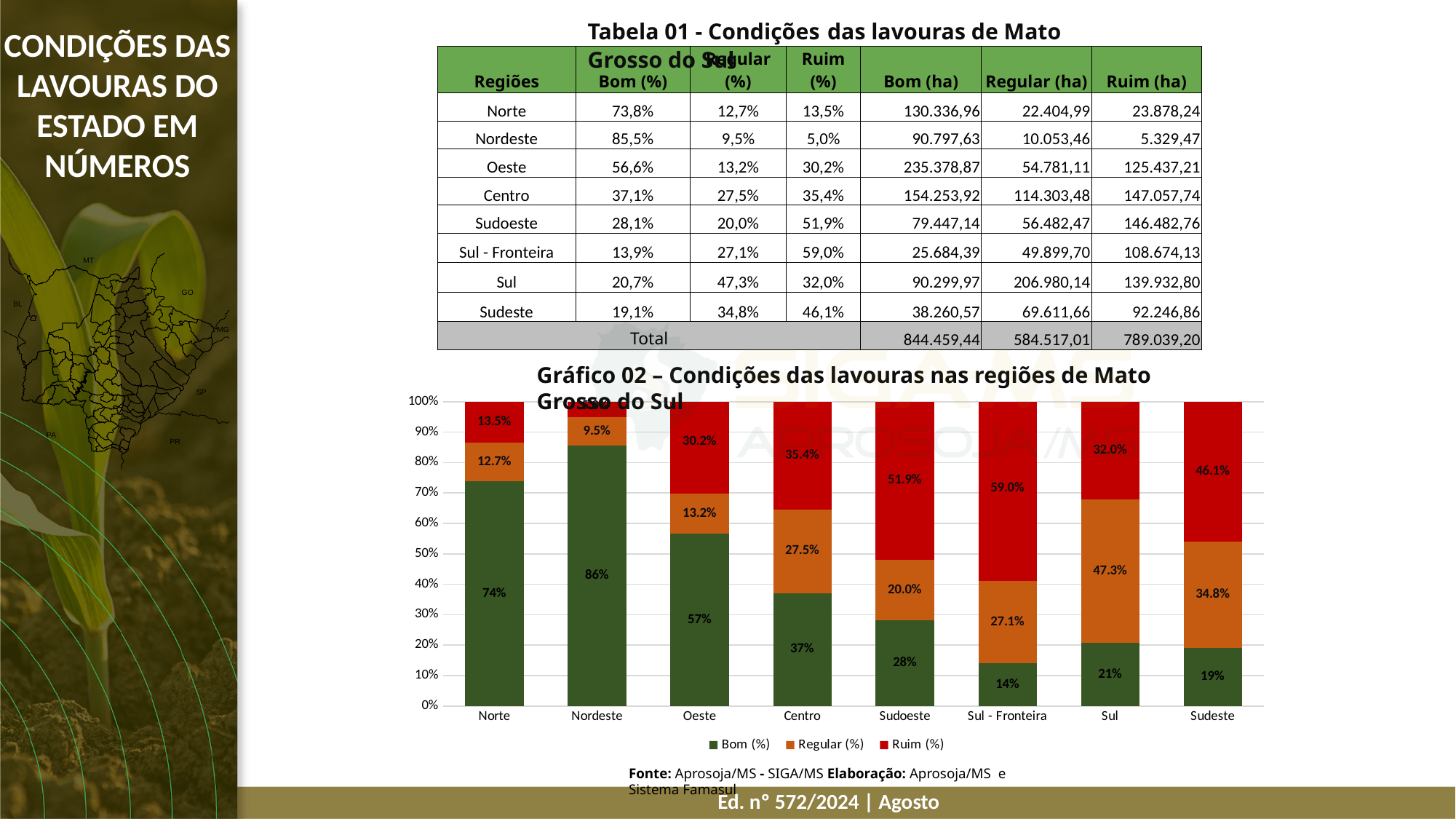
In Gráfico 02, which region has the highest Bom (%) value? Nordeste In Gráfico 02, is the Ruim (%) value larger for Sudoeste or for Sudeste? Sudoeste In Gráfico 02, what is the difference between the Regular (%) values for Sul and Sudeste? 12.5% In Gráfico 02, what is the Bom (%) value for Nordeste? 86% What kind of chart is Gráfico 02? stacked bar chart In Gráfico 02, which region has the highest Ruim (%) value? Sul - Fronteira In Gráfico 02, which region has the lowest Bom (%) value? Sul - Fronteira How many regions are shown on the x axis of Gráfico 02? 8 In Gráfico 02, what is the Ruim (%) value for Sul - Fronteira? 59.0% How many series does the legend of Gráfico 02 list? 3 In Gráfico 02, which colour represents the Ruim (%) series? red In Gráfico 02, what is the Regular (%) value for Sul? 47.3%